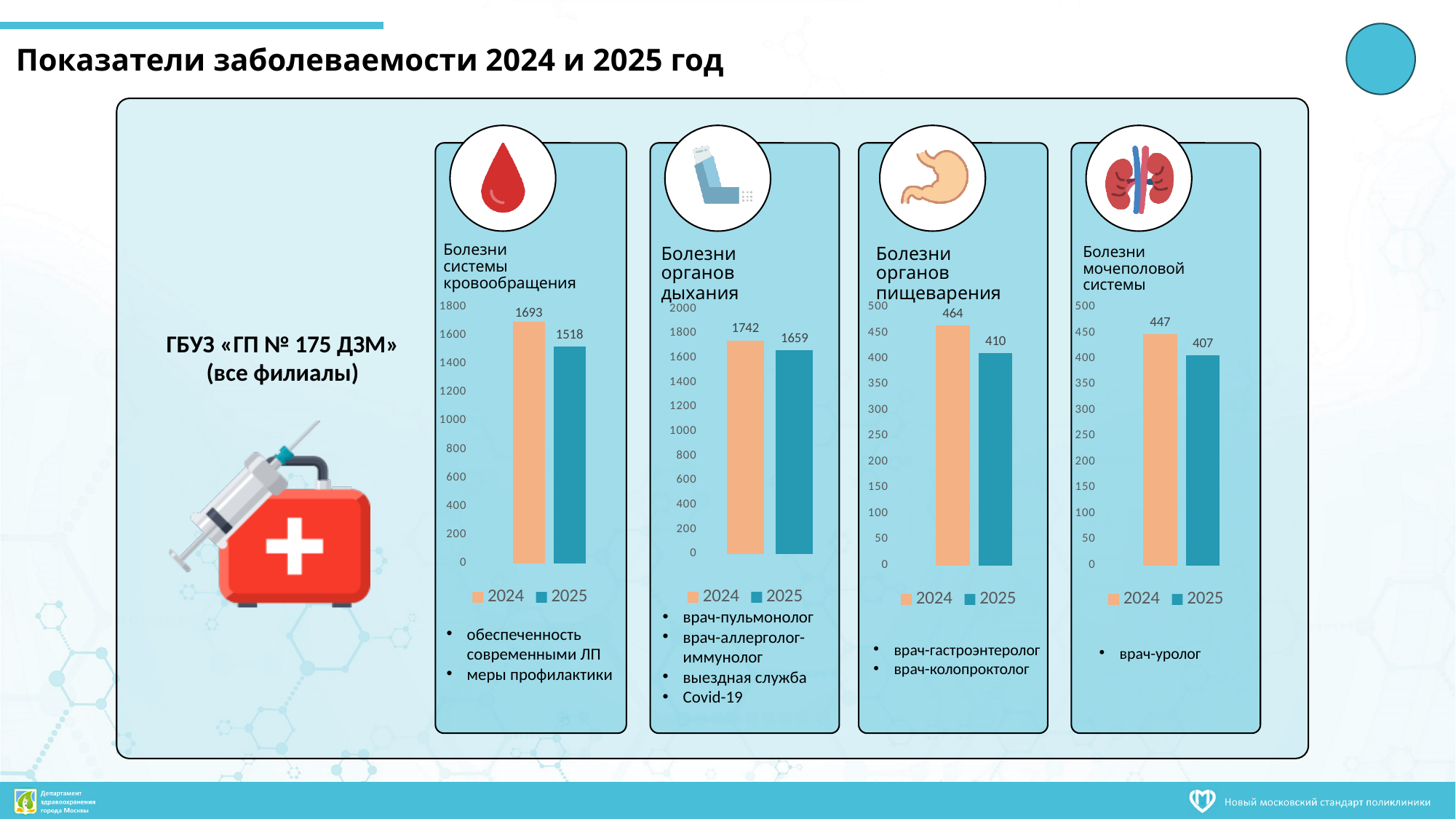
In the chart 'Болезни системы кровообращения', what is the value for 2024? 1693 In the chart 'Болезни органов дыхания', which year has the higher value, 2024 or 2025? 2024 How many series does the legend of the chart 'Болезни органов дыхания' list? 2 In the chart 'Болезни органов дыхания', what is the value for 2025? 1659 In the chart 'Болезни системы кровообращения', what is the difference between the 2024 and 2025 values? 175 In the chart 'Болезни мочеполовой системы', do the values rise or fall from 2024 to 2025? fall In the chart 'Болезни системы кровообращения', what is the value for 2025? 1518 In the chart 'Болезни органов пищеварения', what is the difference between the 2024 and 2025 values? 54 In the chart 'Болезни мочеполовой системы', what is the value for 2025? 407 What kind of chart is the chart 'Болезни мочеполовой системы'? bar chart In the chart 'Болезни органов пищеварения', what is the value for 2024? 464 In the chart 'Болезни органов дыхания', what is the value for 2024? 1742